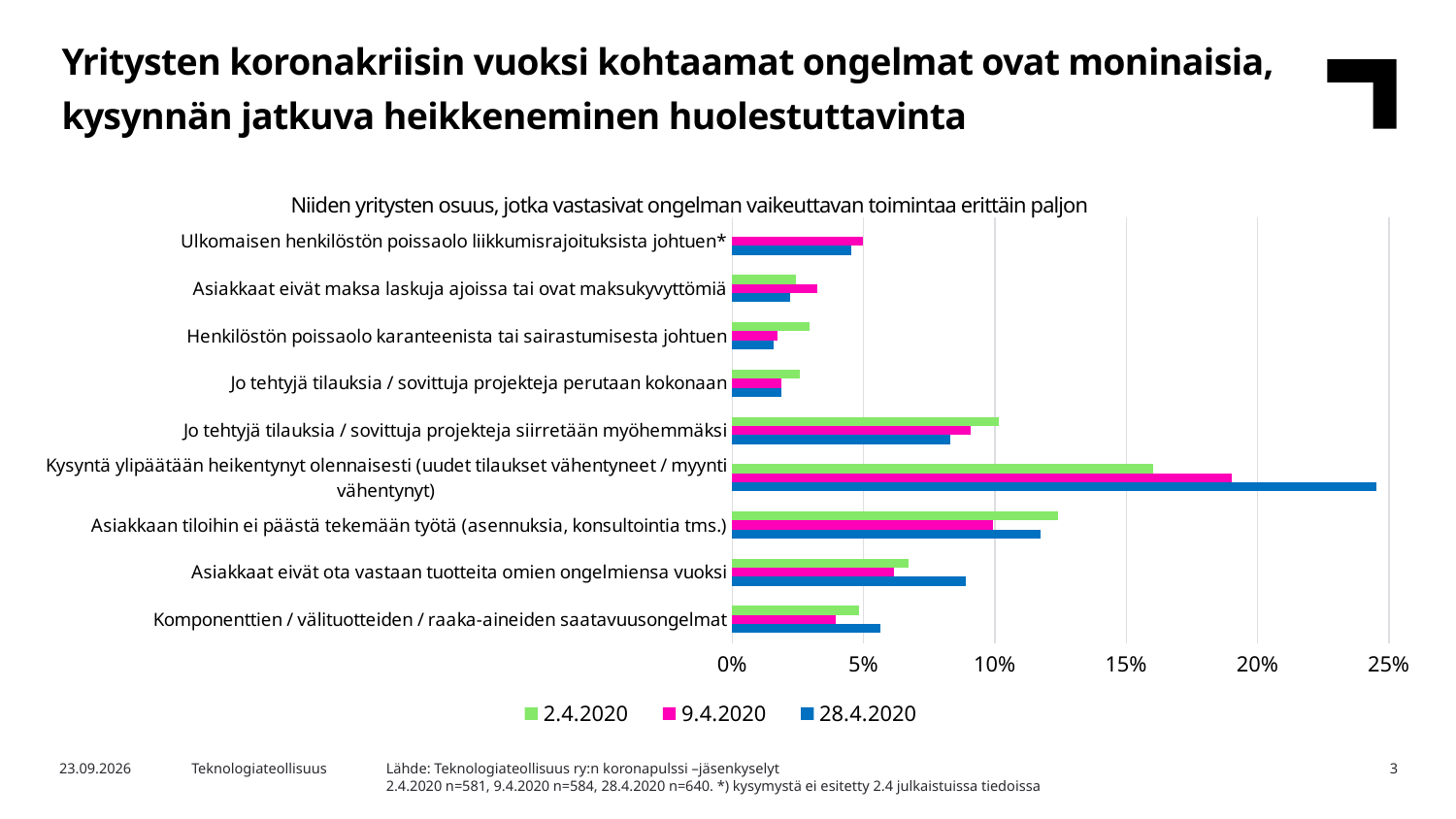
Is the 28.4.2020 value for 'Kysyntä ylipäätään heikentynyt olennaisesti' greater or less than 20%? greater How many series does the chart legend list? 3 What is the title of the chart? Niiden yritysten osuus, jotka vastasivat ongelman vaikeuttavan toimintaa erittäin paljon Is the 2.4.2020 value for 'Kysyntä ylipäätään heikentynyt olennaisesti' greater or less than 15%? greater For 'Asiakkaat eivät ota vastaan tuotteita omien ongelmiensa vuoksi', which series has the larger value: 9.4.2020 or 28.4.2020? 28.4.2020 How many problem categories are plotted on the chart? 9 Which category has the highest value for the 28.4.2020 series? Kysyntä ylipäätään heikentynyt olennaisesti (uudet tilaukset vähentyneet / myynti vähentynyt) For 'Kysyntä ylipäätään heikentynyt olennaisesti', which series has the larger value: 2.4.2020 or 28.4.2020? 28.4.2020 Which colour represents the 28.4.2020 series in the chart? Blue What kind of chart is shown on the slide? Bar chart Is the 2.4.2020 value for 'Asiakkaan tiloihin ei päästä tekemään työtä' greater or less than 10%? greater